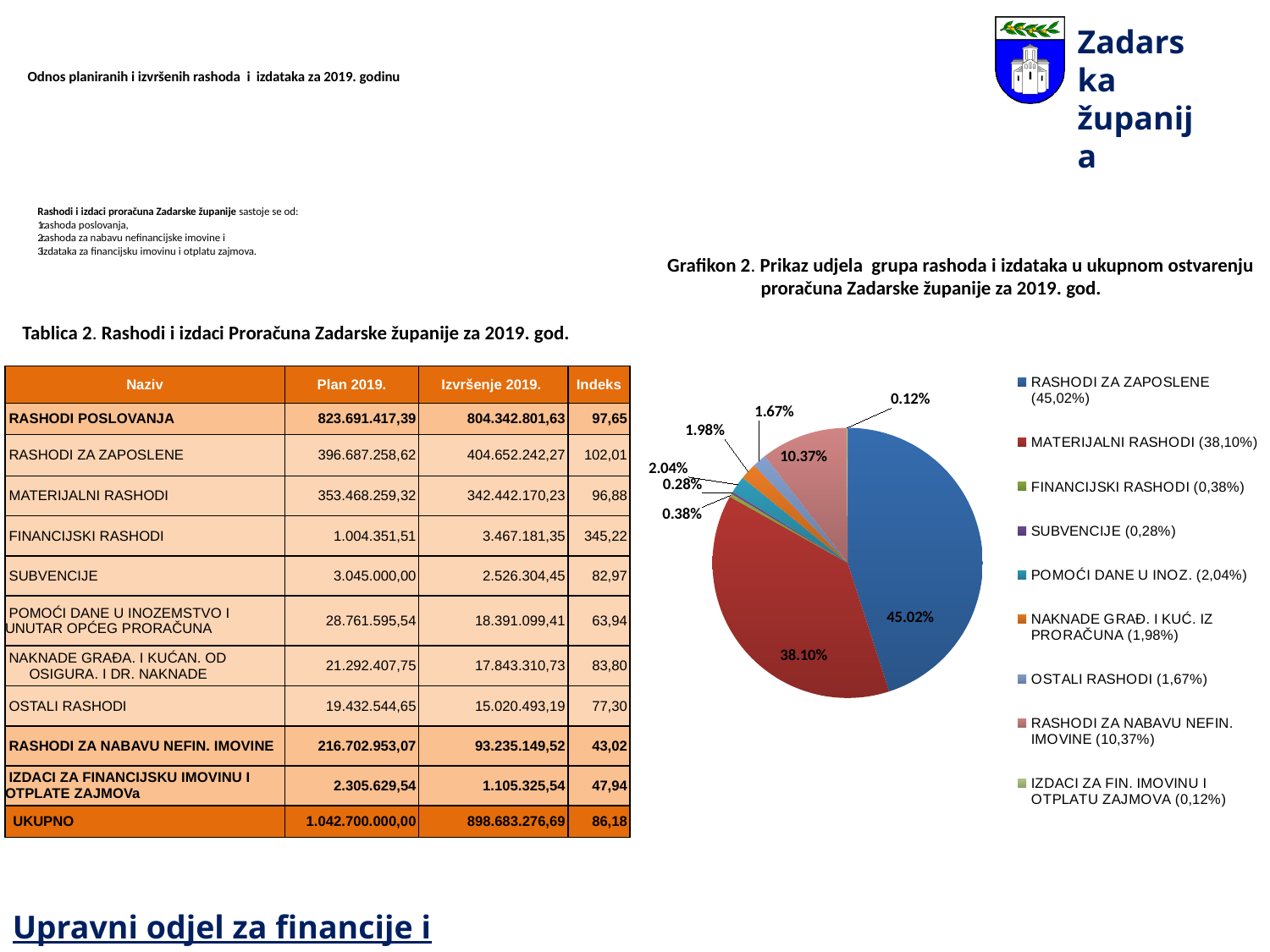
Which category has the smallest slice in the pie chart? IZDACI ZA FIN. IMOVINU I OTPLATU ZAJMOVA In the pie chart, what share is shown for SUBVENCIJE? 0.28% In the pie chart, what share is shown for IZDACI ZA FIN. IMOVINU I OTPLATU ZAJMOVA? 0.12% What kind of chart is shown in Grafikon 2? pie chart What is the title of the pie chart on the slide? Grafikon 2. Prikaz udjela grupa rashoda i izdataka u ukupnom ostvarenju proračuna Zadarske županije za 2019. god. Which category has the largest slice in the pie chart? RASHODI ZA ZAPOSLENE In the pie chart, what share is shown for MATERIJALNI RASHODI? 38.10% In the pie chart, what share is shown for RASHODI ZA ZAPOSLENE? 45.02% In the pie chart, which is larger: the share for POMOĆI DANE U INOZ. or the share for OSTALI RASHODI? POMOĆI DANE U INOZ. In the pie chart, what is the difference in percentage points between the shares for RASHODI ZA ZAPOSLENE and MATERIJALNI RASHODI? 6.92 In the pie chart, what share is shown for RASHODI ZA NABAVU NEFIN. IMOVINE? 10.37% How many categories does the legend of the pie chart list? 9